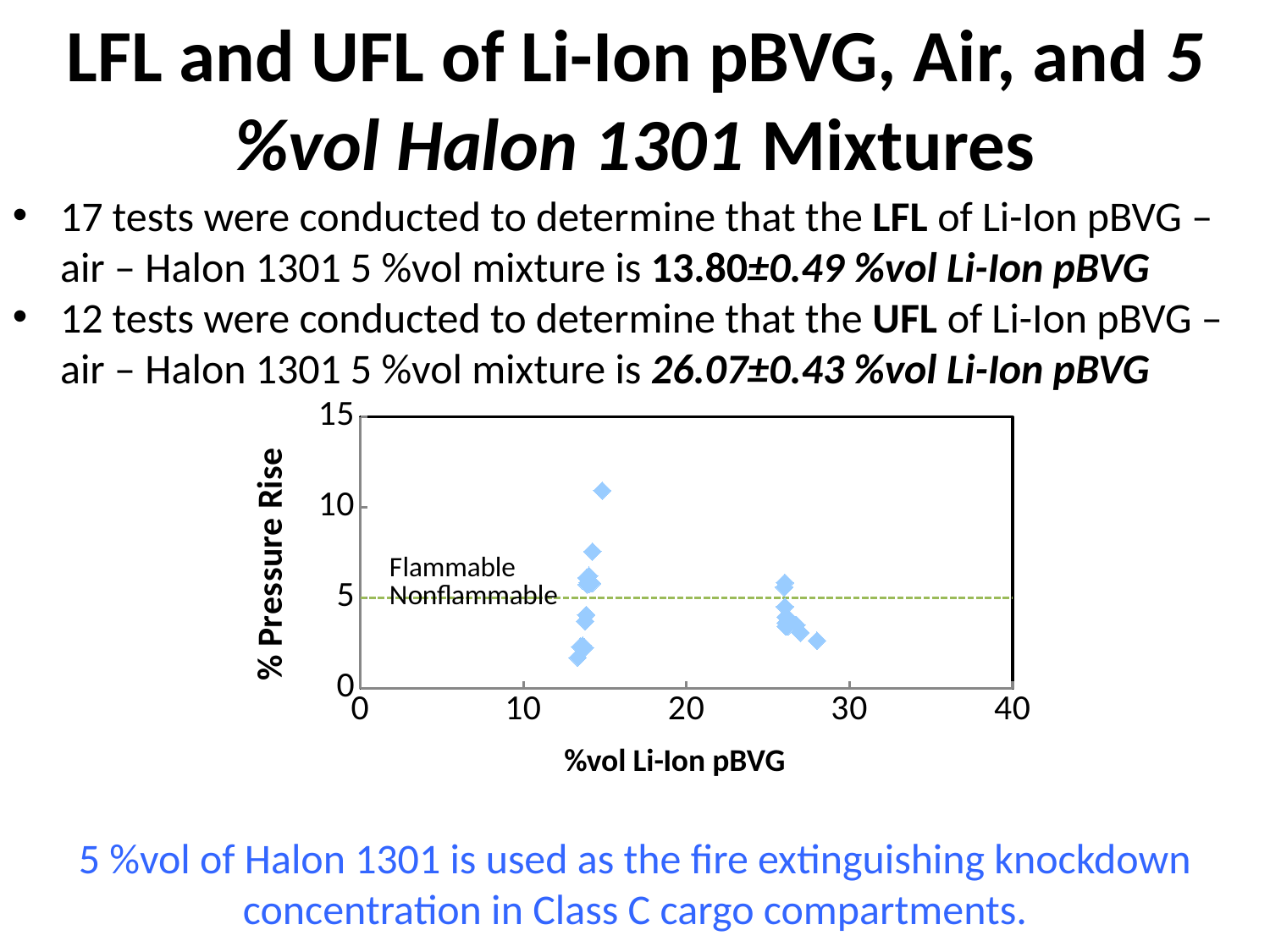
What is the maximum value shown on the x axis of the chart? 40 What is the maximum value shown on the y axis of the chart? 15 At what % Pressure Rise value is the dashed horizontal line separating Flammable from Nonflammable drawn? 5 What is the title of the x axis of the chart? %vol Li-Ion pBVG What kind of chart is shown on the slide? scatter chart Is the lowest plotted point's % Pressure Rise greater or less than 5? less Is the highest plotted point's % Pressure Rise greater or less than 5? greater Which group of points contains the highest % Pressure Rise: the group near 14 %vol Li-Ion pBVG or the group near 27 %vol Li-Ion pBVG? the group near 14 %vol Li-Ion pBVG Is the highest plotted point's % Pressure Rise greater or less than 10? greater How many distinct clusters of points are plotted along the x axis? 2 What is the title of the y axis of the chart? % Pressure Rise